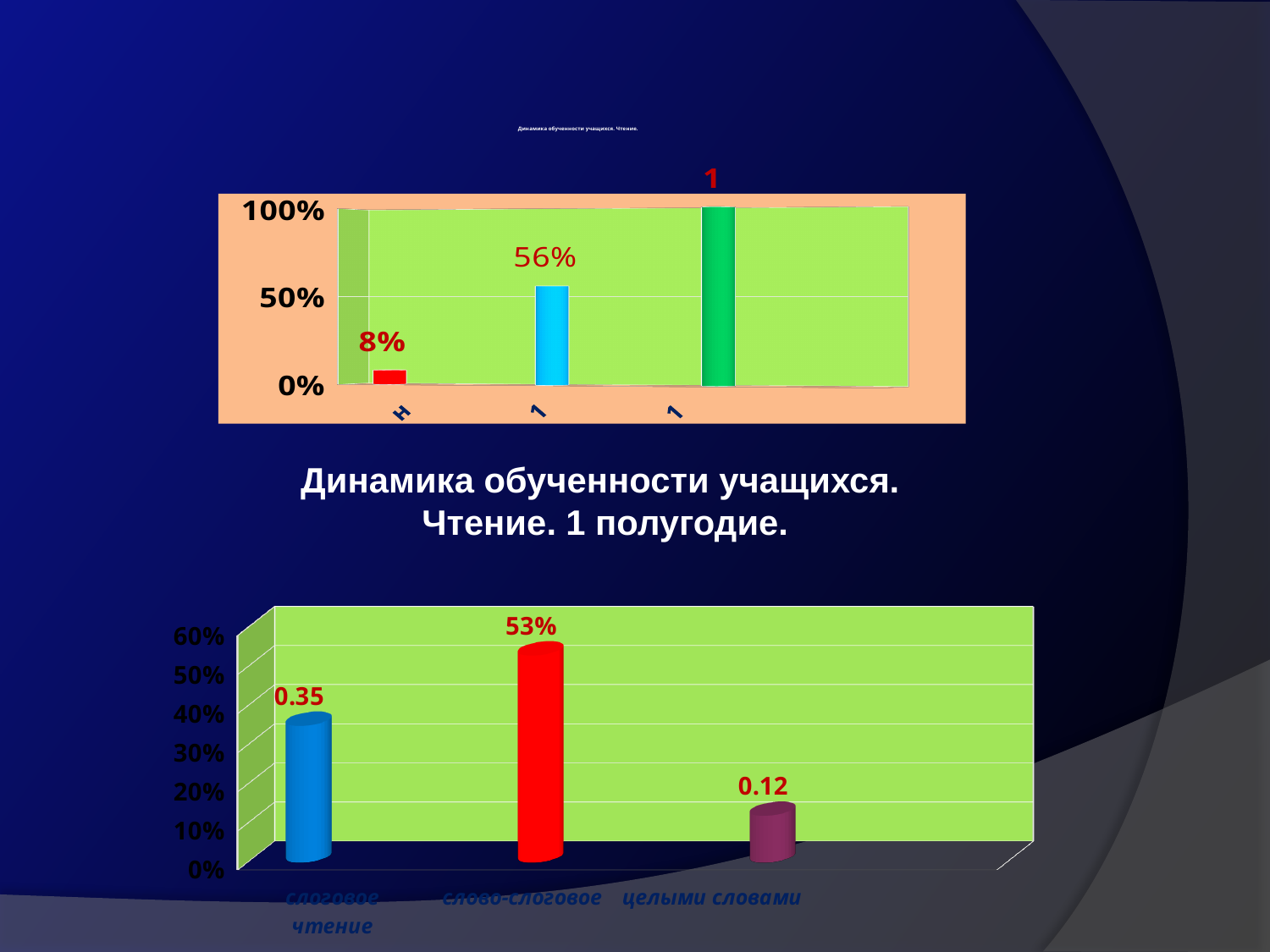
In the top chart, what value is labelled on the second (blue) bar? 56% In the top chart, what value is labelled on the first (red) bar? 8% In the bottom chart, what is the value for слово-слоговое? 53% In the top chart, what is the difference between the second bar (56%) and the first bar (8%)? 48% In the bottom chart (Динамика обученности учащихся. Чтение. 1 полугодие.), what is the value for слоговое чтение? 0.35 In the bottom chart, which category has the highest value? слово-слоговое In the bottom chart, which category has the lowest value? целыми словами What kind of chart is the bottom chart? bar chart In the top chart, which bar is the lowest? the first (red) bar In the bottom chart, what is the value for целыми словами? 0.12 In the top chart, what label is printed above the third (green) bar? 1 In the top chart, how many bars are plotted? 3